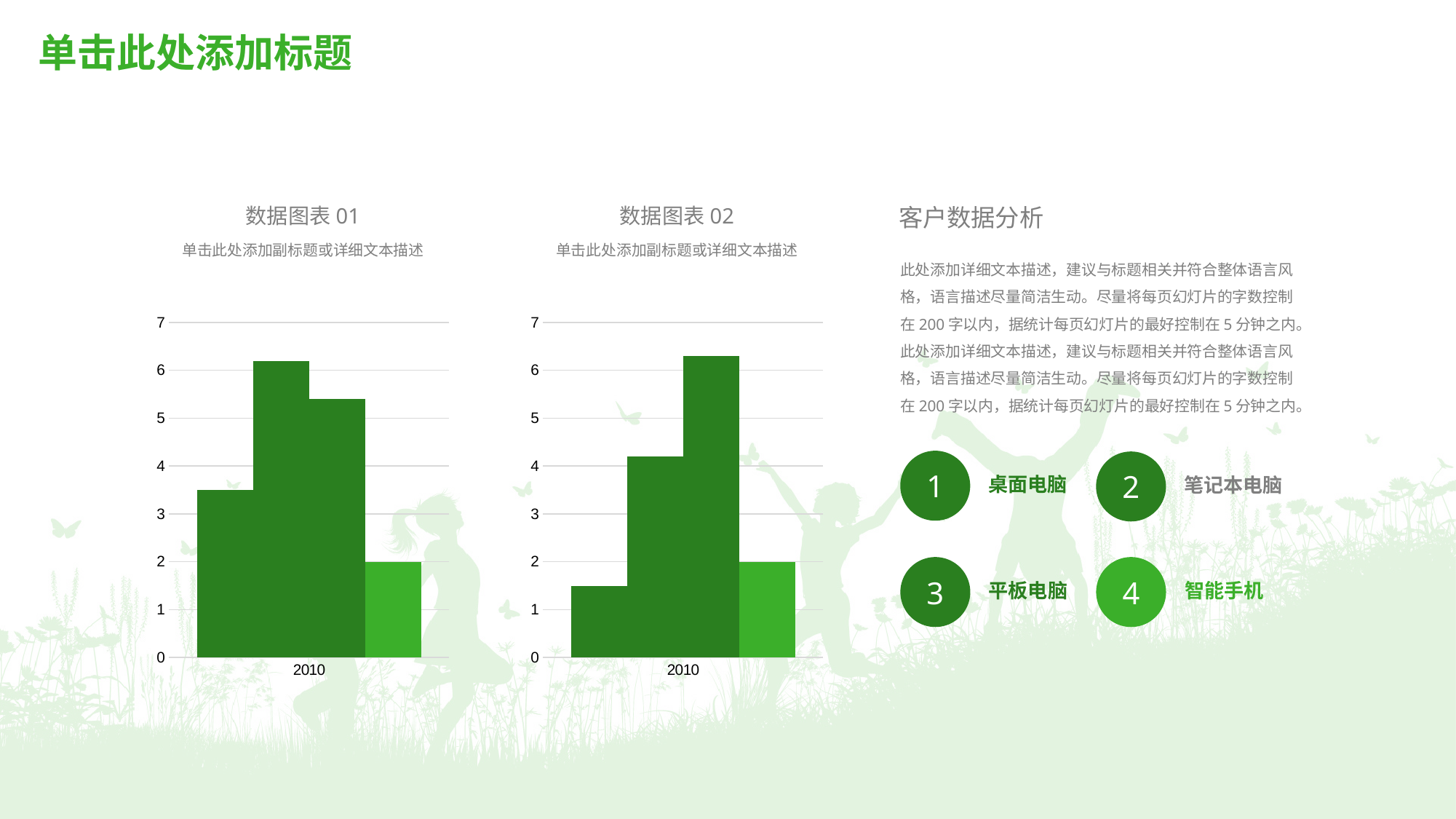
In 数据图表 01, what is the value of the fourth (light green) bar? 2 In 数据图表 02, what is the highest value shown on the vertical axis? 7 In 数据图表 02, which bar is the tallest? the third bar In 数据图表 02, is the value of the first bar greater or less than 2? less In 数据图表 01, how many bars are plotted? 4 In 数据图表 01, which bar is the tallest? the second bar In 数据图表 01, is the value of the second bar greater or less than 6? greater In 数据图表 01, which bar is the shortest? the fourth (light green) bar In 数据图表 02, which bar is the shortest? the first bar What kind of chart is 数据图表 01? bar chart In 数据图表 01, what is the category label shown on the x axis? 2010 In 数据图表 01, which is larger, the second bar or the third bar? the second bar